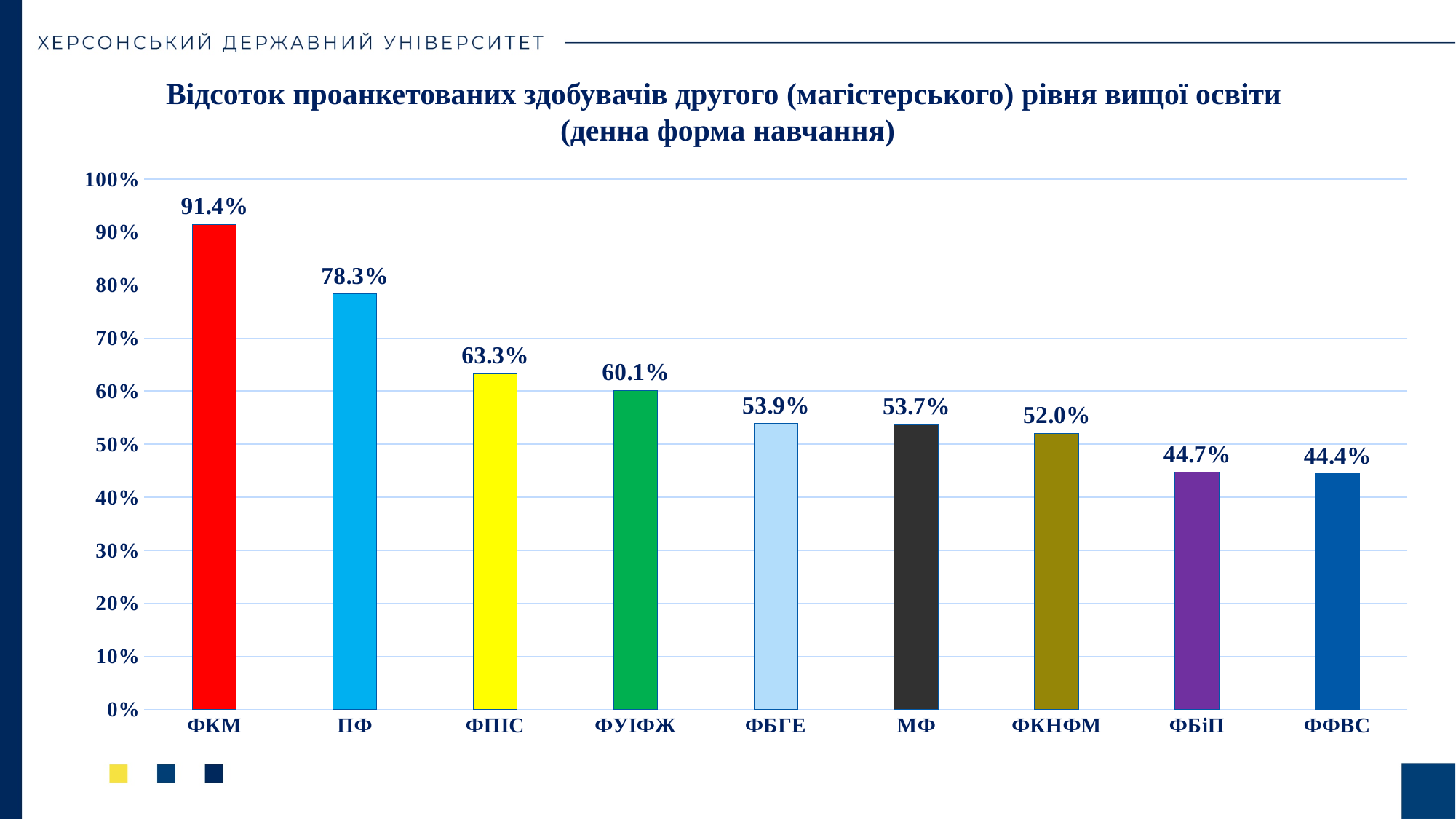
What is the difference between the values for ФКМ and ПФ? 13.1% What is the value for ФБГЕ? 53.9% How many categories are shown on the x axis? 9 What kind of chart is shown on the slide? bar chart What is the difference between the values for ФПІС and ФКНФМ? 11.3% What is the value for ФКМ? 91.4% Do the values rise or fall from left to right along the x axis? fall Which is larger, the value for ПФ or the value for ФУІФЖ? ПФ Which category has the highest value? ФКМ Is the value for ФБіП greater or less than 50%? less Which category has the lowest value? ФФВС What is the value for ФФВС? 44.4%